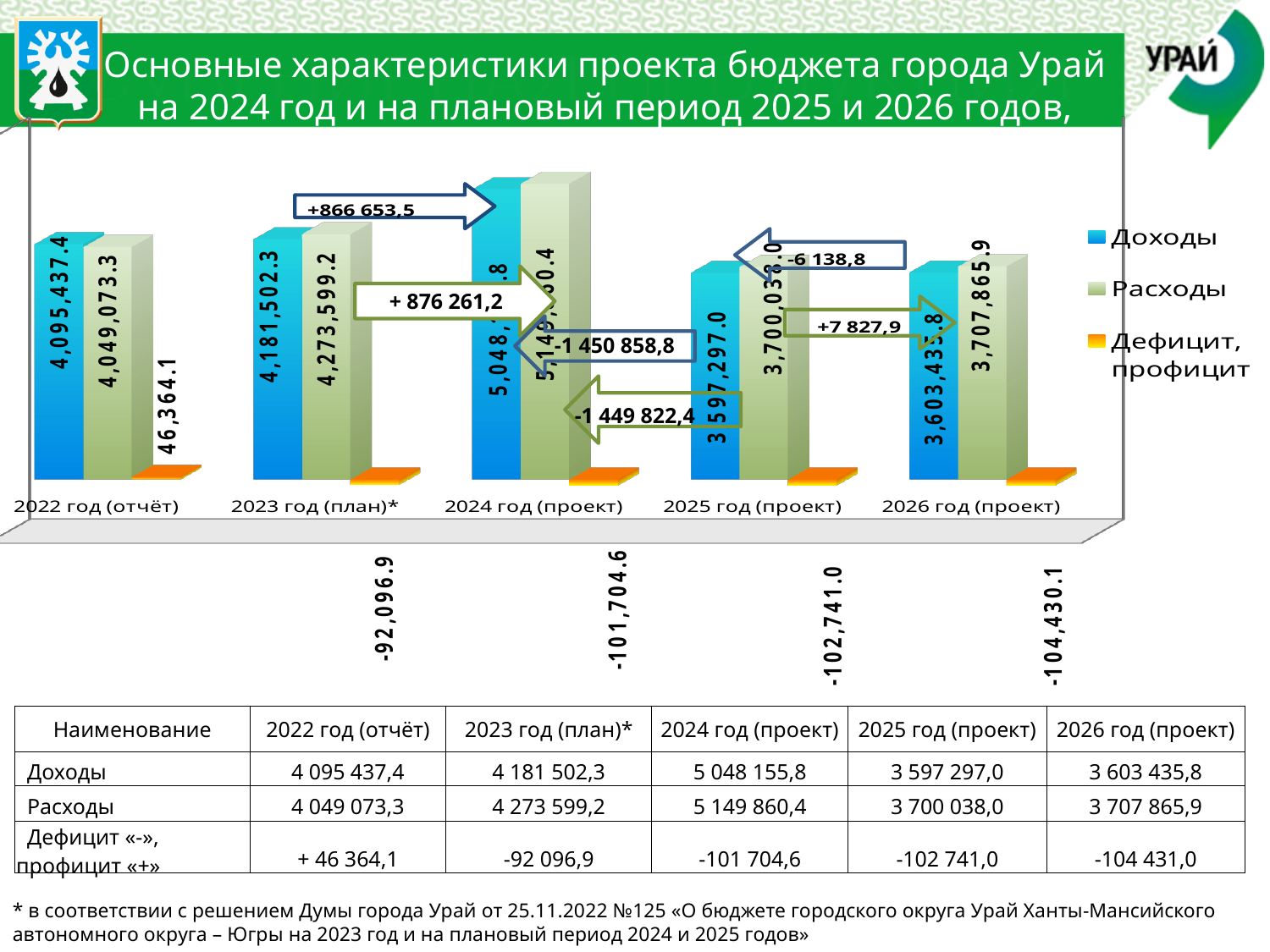
What is the value of Доходы for 2022 год (отчёт)? 4,095,437.4 How many series does the chart legend list? 3 What is the value of Расходы for 2023 год (план)*? 4,273,599.2 Which year has the highest value of Доходы? 2024 год (проект) What is the difference between Доходы in 2023 год (план)* and Доходы in 2022 год (отчёт)? 86,064.9 What is the value of Расходы for 2026 год (проект)? 3,707,865.9 What kind of chart is shown on the slide? bar chart What is the difference between Доходы and Расходы in 2022 год (отчёт)? 46,364.1 In 2022 год (отчёт), which is larger: Доходы or Расходы? Доходы Which year has the lowest value of Дефицит, профицит? 2026 год (проект) How many year categories are shown on the x axis of the chart? 5 What is the value of Дефицит, профицит for 2024 год (проект)? -101,704.6